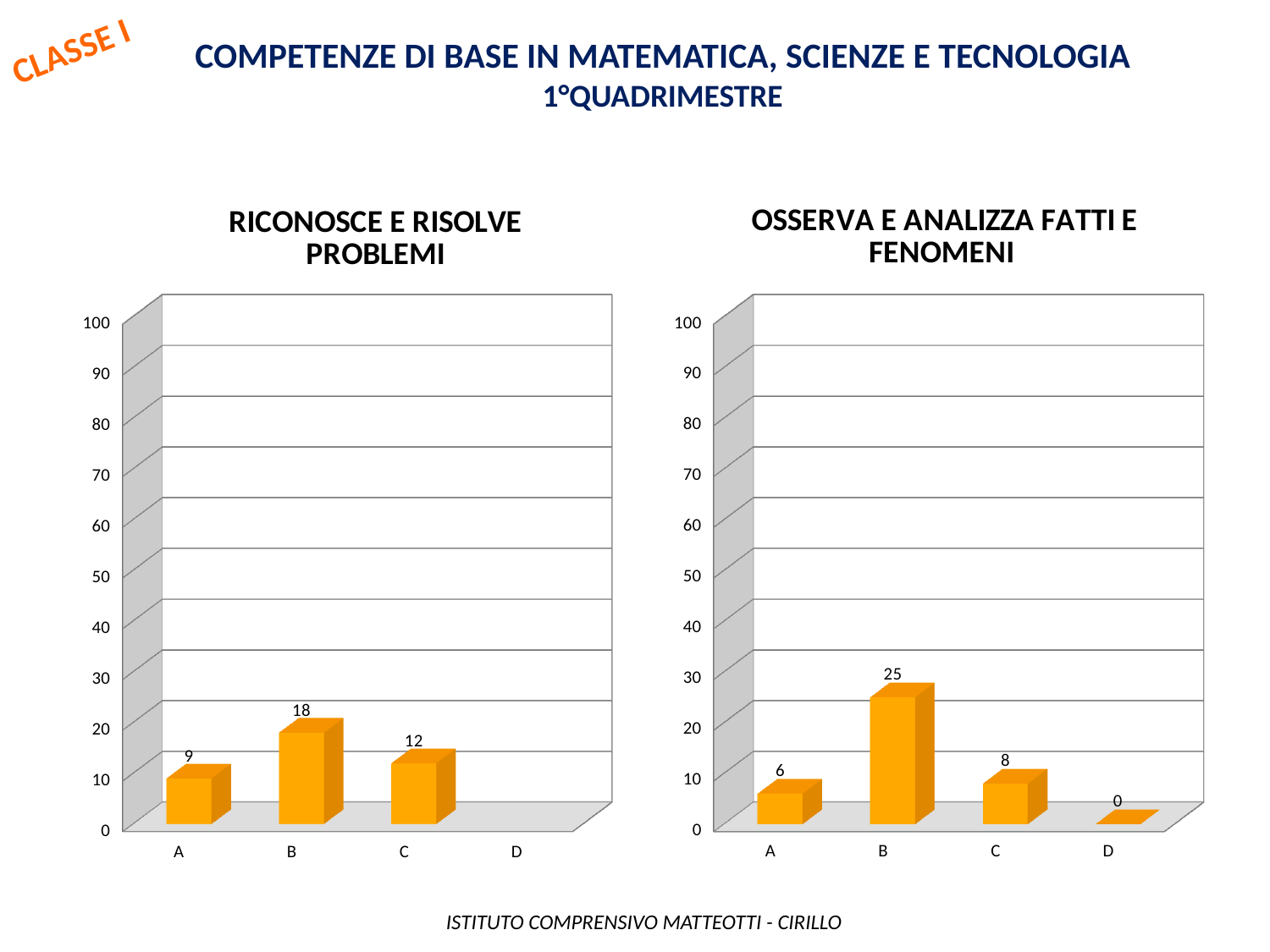
In the 'RICONOSCE E RISOLVE PROBLEMI' chart, what is the difference between the values for B and C? 6 What kind of chart is the 'OSSERVA E ANALIZZA FATTI E FENOMENI' chart? Bar chart In the 'OSSERVA E ANALIZZA FATTI E FENOMENI' chart, what is the difference between the values for B and A? 19 In the 'OSSERVA E ANALIZZA FATTI E FENOMENI' chart, is the value for B greater or less than 20? greater In the 'OSSERVA E ANALIZZA FATTI E FENOMENI' chart, which is larger, the value for A or the value for C? C In the 'OSSERVA E ANALIZZA FATTI E FENOMENI' chart, which category has the lowest value? D In the 'OSSERVA E ANALIZZA FATTI E FENOMENI' chart, what is the value for category C? 8 In the 'OSSERVA E ANALIZZA FATTI E FENOMENI' chart, what is the value for category D? 0 How many categories are shown on the x axis of the 'RICONOSCE E RISOLVE PROBLEMI' chart? 4 In the 'RICONOSCE E RISOLVE PROBLEMI' chart, what is the value for category A? 9 In the 'RICONOSCE E RISOLVE PROBLEMI' chart, which category has the highest value? B In the 'RICONOSCE E RISOLVE PROBLEMI' chart, what is the value for category B? 18